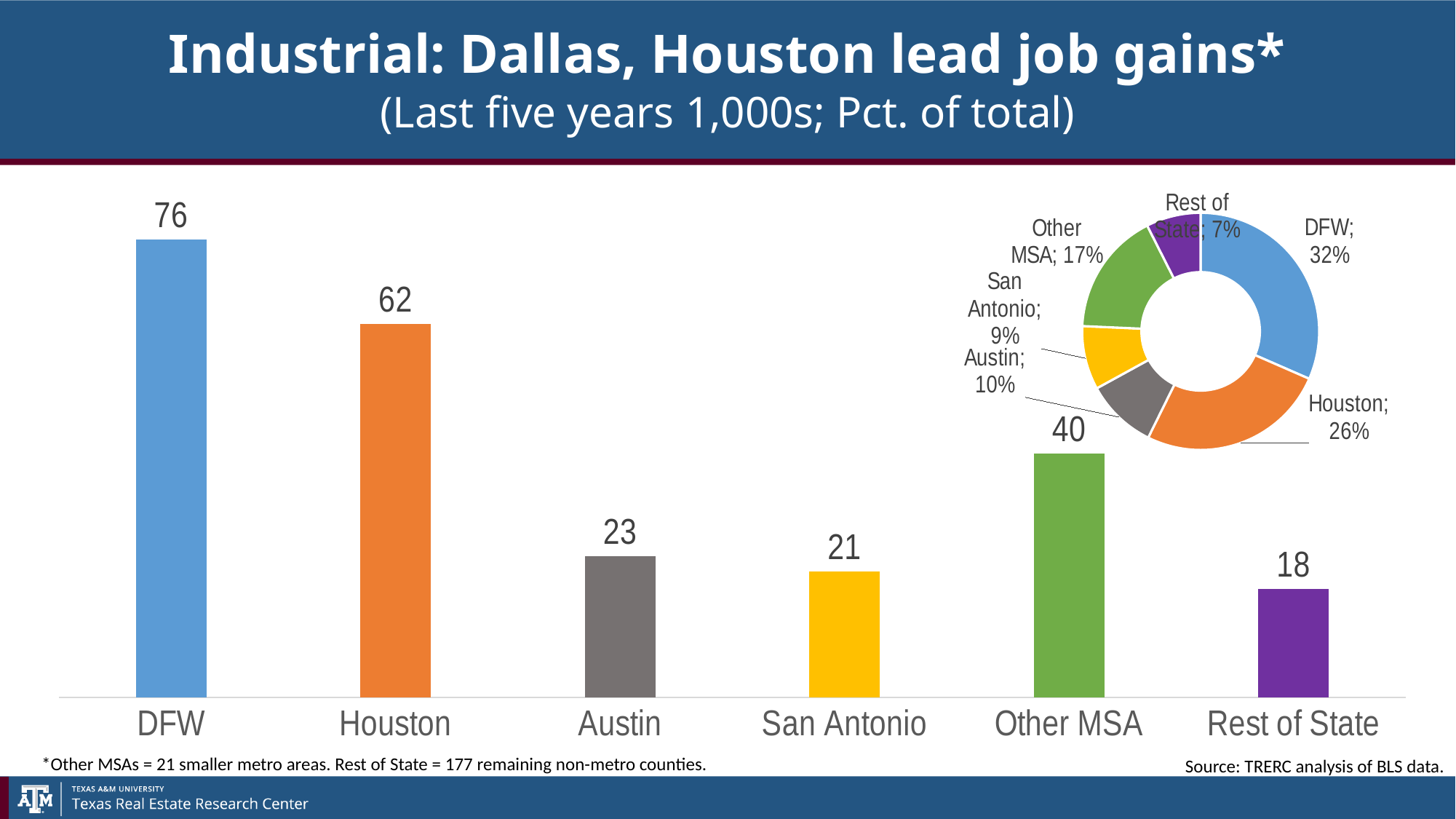
In the doughnut chart, which category has the smallest share? Rest of State In the doughnut chart, what share does Other MSA have? 17% In the bar chart, which is larger, the value for Austin or the value for San Antonio? Austin In the bar chart, what is the value for Other MSA? 40 In the bar chart, what is the difference between the values for DFW and Houston? 14 What kind of chart is the large chart on the left of the slide? Bar chart How many categories does the bar chart show? 6 In the doughnut chart, what share does Houston have? 26% In the bar chart, which category has the highest value? DFW In the bar chart, which category has the lowest value? Rest of State In the bar chart, what is the value for DFW? 76